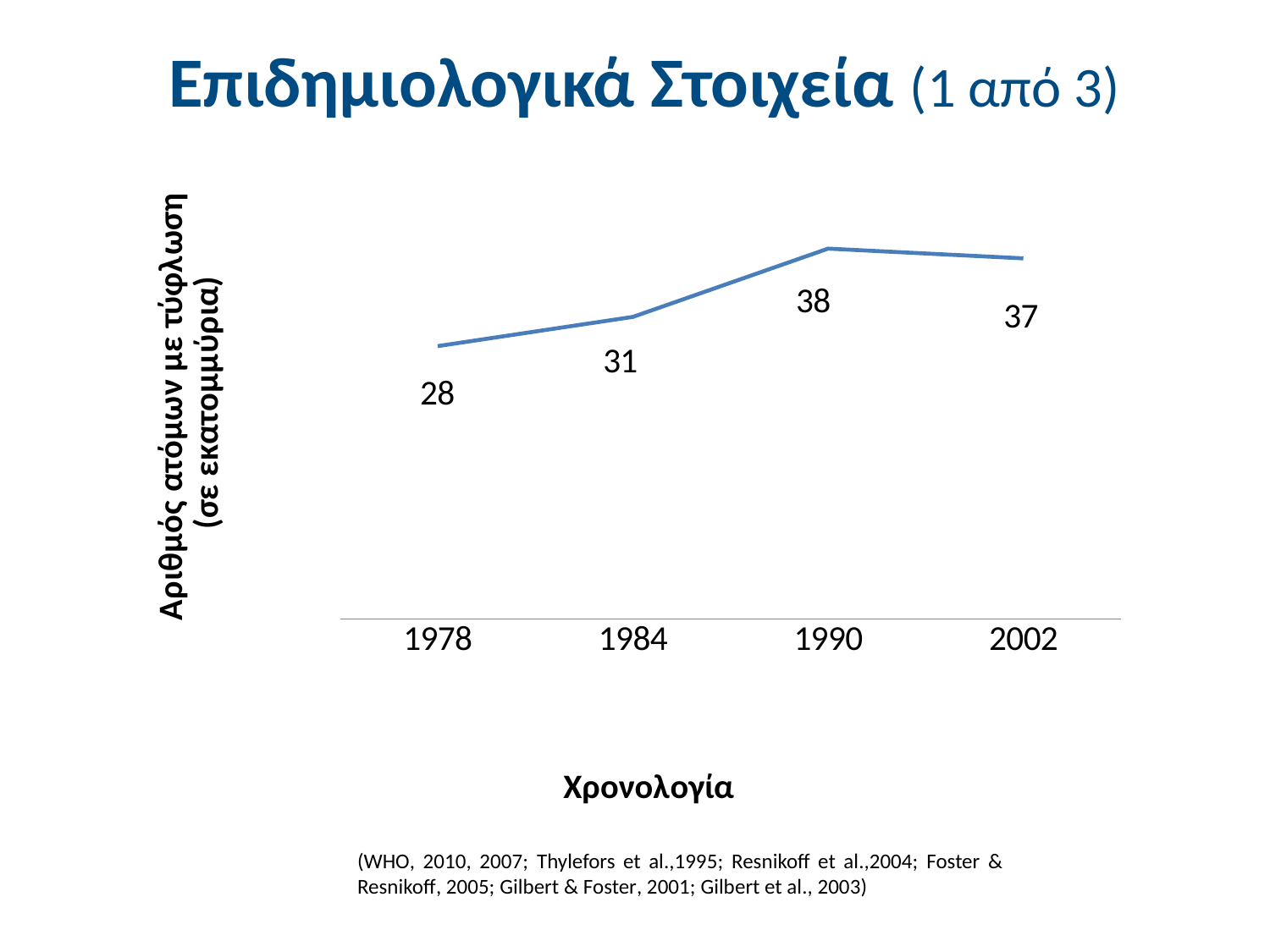
Which year has the highest value? 1990 What is the value for 1978? 28 What is the value for 1990? 38 Which is larger, the value for 1990 or the value for 2002? 1990 What is the value for 2002? 37 What kind of chart is shown on the slide? line chart Which year has the lowest value? 1978 How many data points are plotted on the chart? 4 What is the difference between the values for 1984 and 1978? 3 What is the difference between the values for 1990 and 1978? 10 What is the label of the x axis? Χρονολογία What is the value for 1984? 31